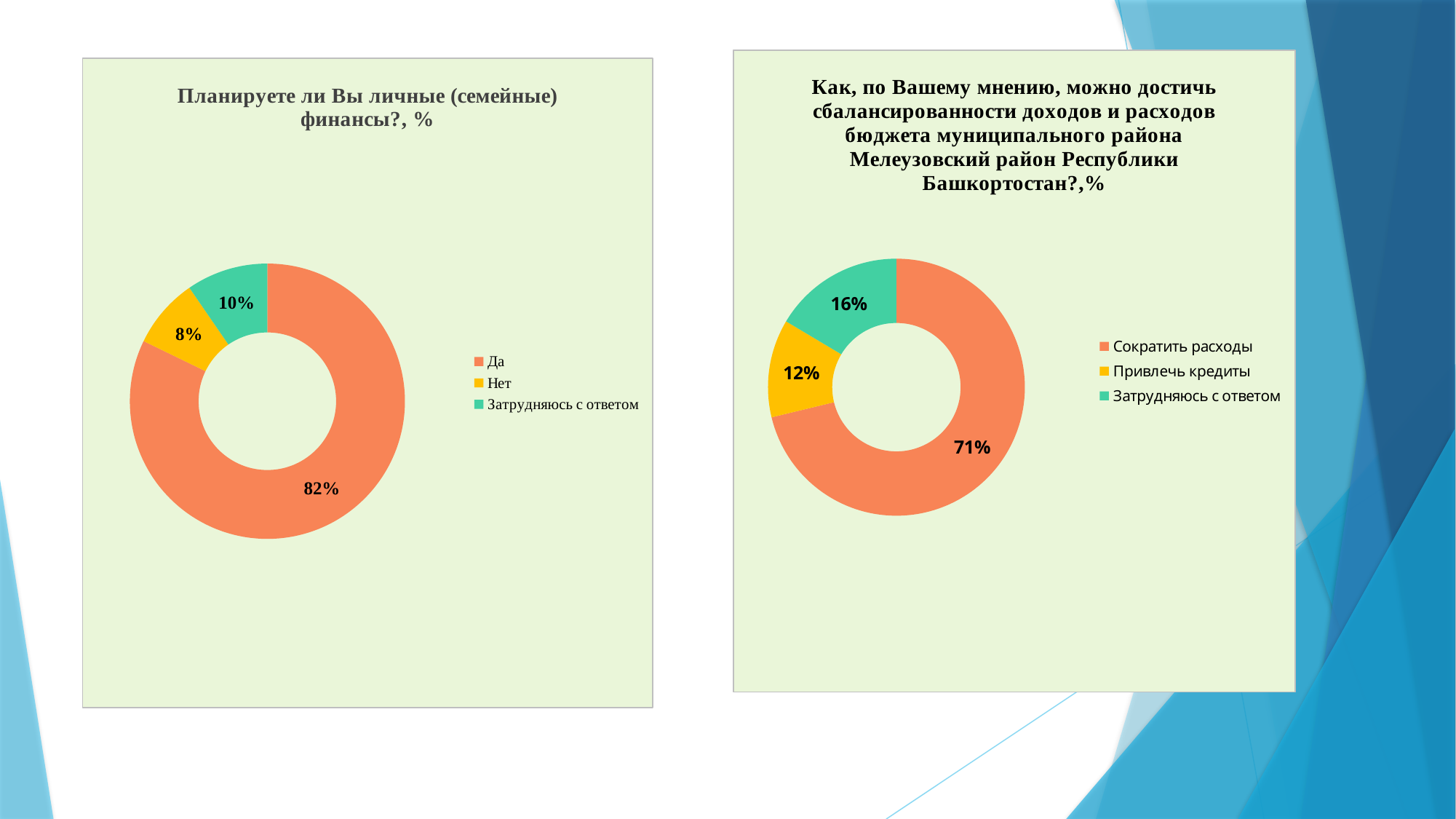
In the right chart (about balancing the budget of Мелеузовский район), what share of respondents chose "Привлечь кредиты"? 12% What type of chart is used on the left side of the slide? Doughnut (pie) chart In the left chart ("Планируете ли Вы личные (семейные) финансы?"), what share of respondents answered "Затрудняюсь с ответом"? 10% In the left chart ("Планируете ли Вы личные (семейные) финансы?"), how many categories does the legend list? 3 In the left chart ("Планируете ли Вы личные (семейные) финансы?"), what share of respondents answered "Да"? 82% In the left chart ("Планируете ли Вы личные (семейные) финансы?"), which answer has the smallest share? Нет In the right chart (about balancing the budget of Мелеузовский район), what share of respondents chose "Затрудняюсь с ответом"? 16% In the right chart (about balancing the budget of Мелеузовский район), what share of respondents chose "Сократить расходы"? 71% In the right chart (about balancing the budget of Мелеузовский район), which answer has the largest share? Сократить расходы In the left chart ("Планируете ли Вы личные (семейные) финансы?"), what share of respondents answered "Нет"? 8% In the left chart ("Планируете ли Вы личные (семейные) финансы?"), what is the difference between the shares for "Да" and "Нет"? 74% In the right chart (about balancing the budget of Мелеузовский район), which is larger: the share for "Привлечь кредиты" or for "Затрудняюсь с ответом"? Затрудняюсь с ответом